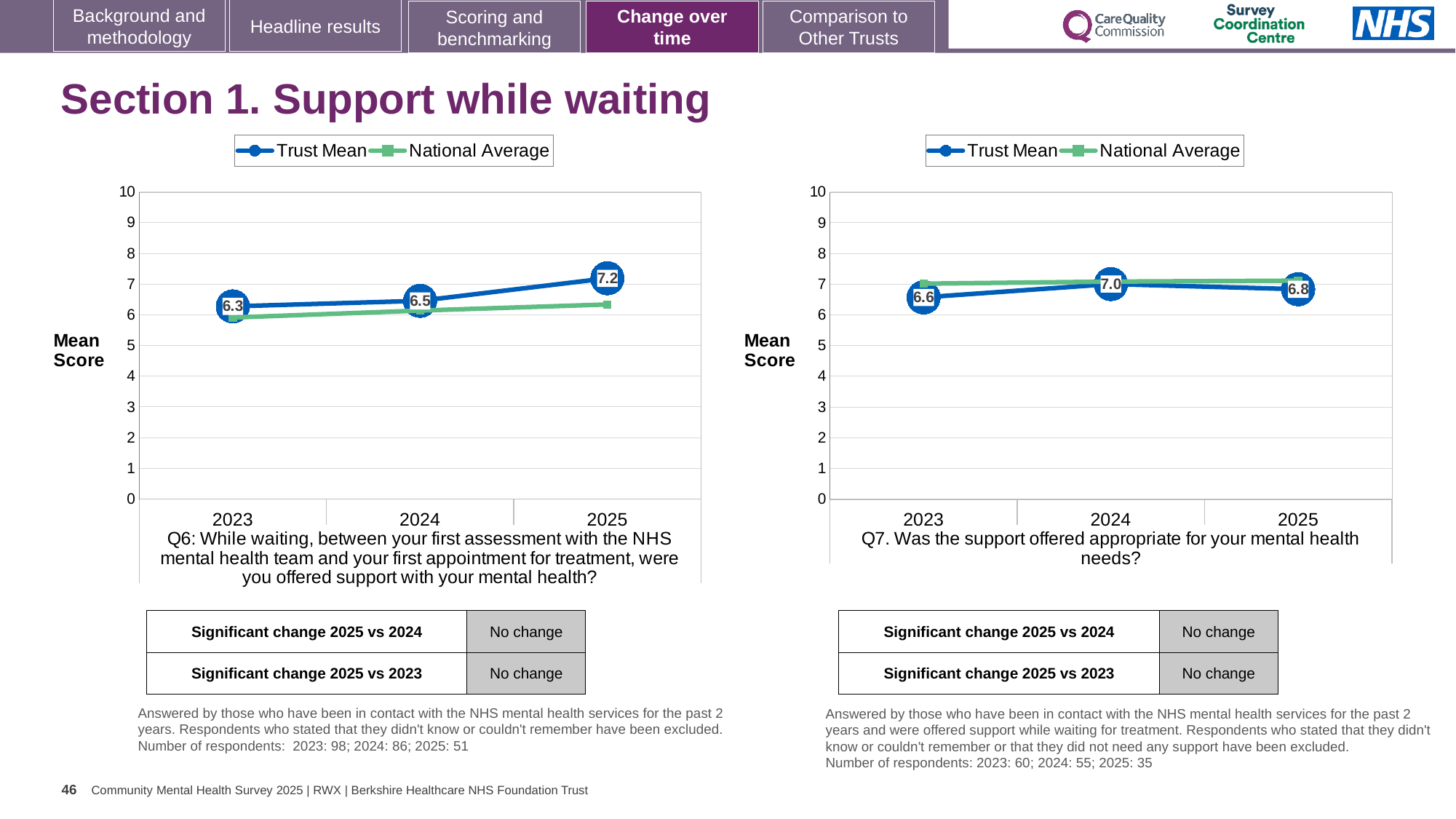
What kind of chart is the Q6 chart (left)? line chart On the Q7 chart (right), is the National Average for 2023 greater or less than 6? greater On the Q6 chart (left), what is the difference between the Trust Mean for 2025 and 2023? 0.9 How many series does the legend of the Q7 chart (right) list? 2 On the Q7 chart (right), what is the Trust Mean for 2024? 7.0 On the Q7 chart (right), which year has the lowest Trust Mean? 2023 On the Q7 chart (right), what is the difference between the Trust Mean for 2024 and 2025? 0.2 On the Q6 chart (left), what is the Trust Mean for 2023? 6.3 On the Q6 chart (left), does the Trust Mean rise or fall from 2023 to 2025? rise On the Q6 chart (left), which year has the highest Trust Mean? 2025 On the Q6 chart (left), in 2025 which is larger, the Trust Mean or the National Average? Trust Mean On the Q6 chart (left), what is the Trust Mean for 2025? 7.2